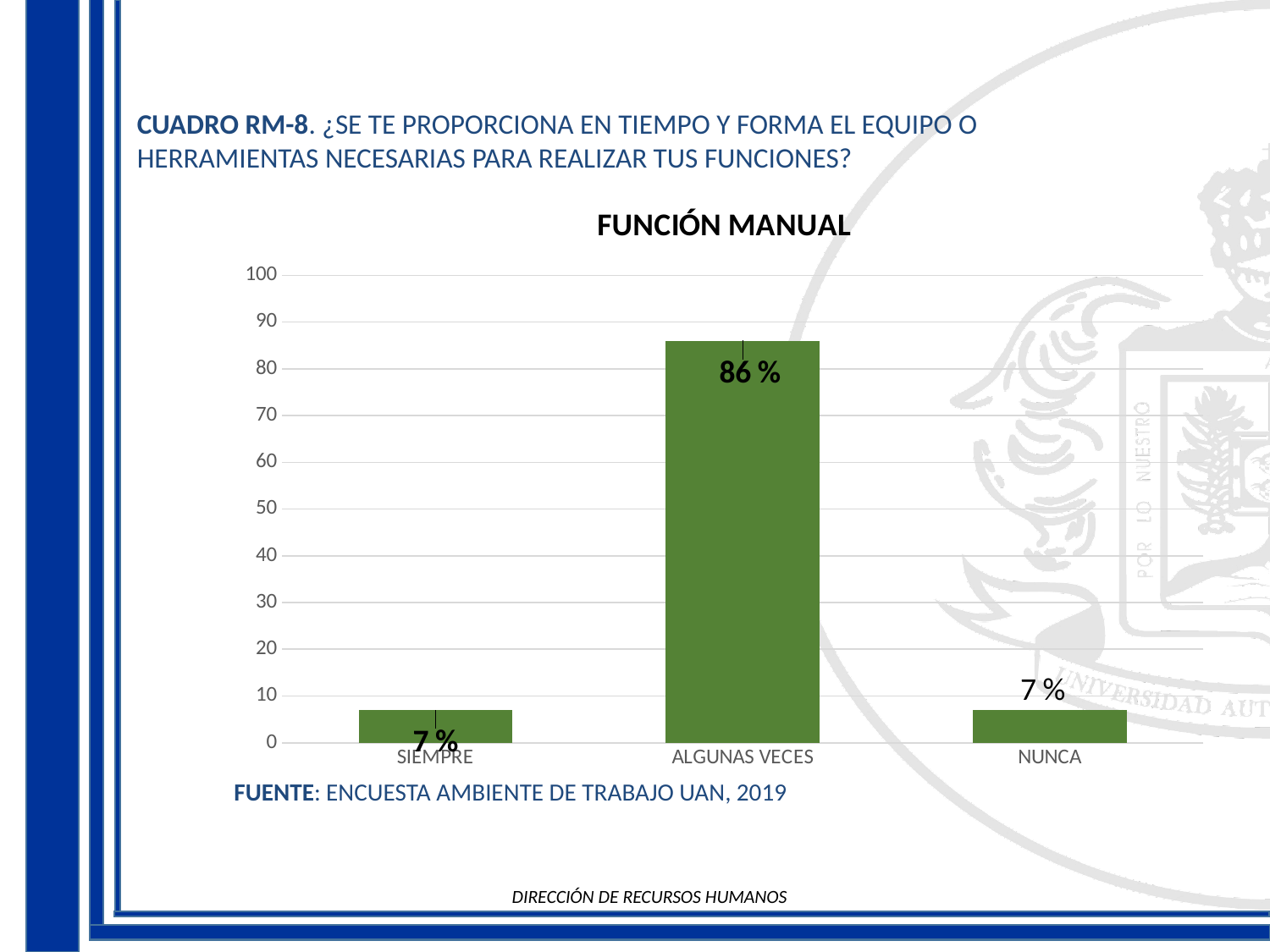
Is the value for ALGUNAS VECES greater or less than 80? greater What is the value for SIEMPRE? 7 % Is the value for NUNCA greater or less than 10? less How many categories are shown on the x axis? 3 Which is larger, the value for ALGUNAS VECES or the value for SIEMPRE? ALGUNAS VECES What is the value for ALGUNAS VECES? 86 % What is the title of the chart? FUNCIÓN MANUAL What is the difference between the values for ALGUNAS VECES and NUNCA? 79 % What is the value for NUNCA? 7 % What is the highest value shown on the y axis? 100 Which category has the highest value? ALGUNAS VECES What kind of chart is shown on the slide? bar chart